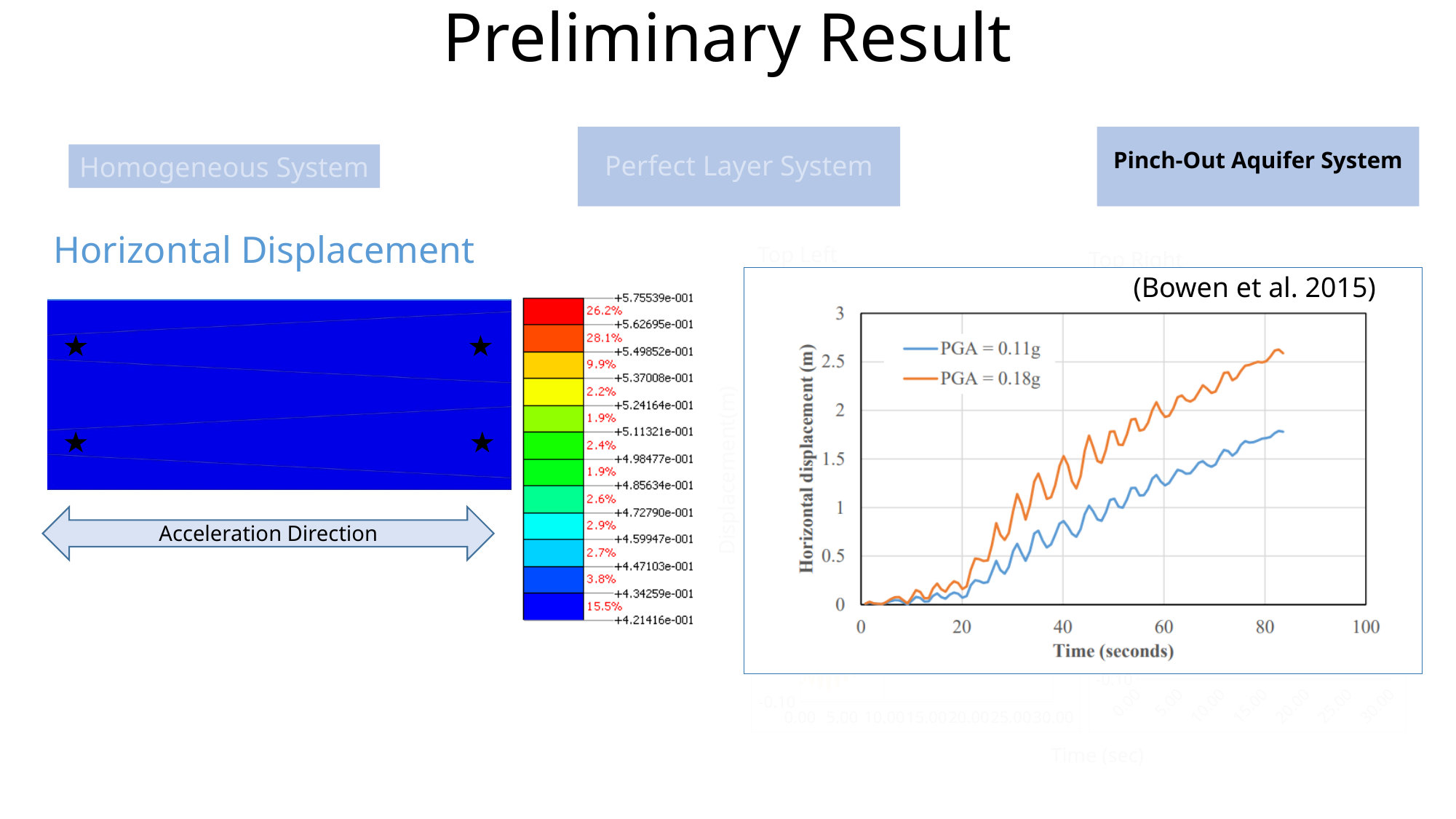
In the Bowen et al. 2015 chart, is the horizontal displacement for PGA = 0.11g at 80 seconds greater or less than 1.5 m? greater What are the two series named in the legend of the Bowen et al. 2015 chart? PGA = 0.11g and PGA = 0.18g In the Bowen et al. 2015 chart, is the horizontal displacement for PGA = 0.11g at 60 seconds greater or less than 1.5 m? less How many series does the legend of the Bowen et al. 2015 chart list? 2 What type of chart is shown in the Pinch-Out Aquifer System panel (Bowen et al. 2015)? line chart In the Bowen et al. 2015 chart, is the horizontal displacement for PGA = 0.18g at 20 seconds greater or less than 0.5 m? less In the Bowen et al. 2015 chart, which series has the larger horizontal displacement at 60 seconds, PGA = 0.11g or PGA = 0.18g? PGA = 0.18g What is the y-axis label of the Bowen et al. 2015 chart? Horizontal displacement (m) In the Bowen et al. 2015 chart, does horizontal displacement rise or fall as time increases? rise In the Bowen et al. 2015 chart, which series reaches the highest horizontal displacement? PGA = 0.18g